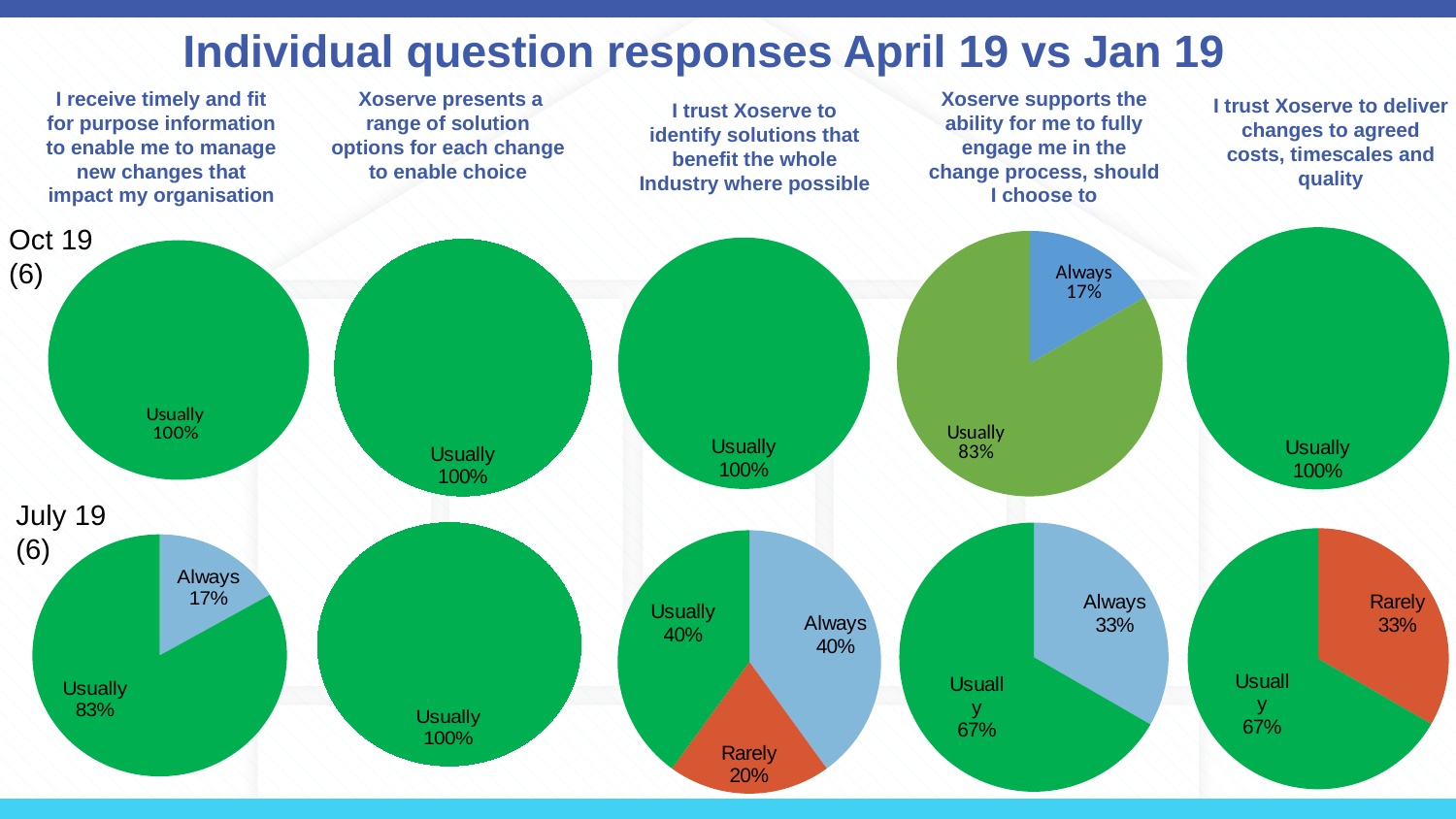
In the July 19 pie chart for "I trust Xoserve to deliver changes to agreed costs, timescales and quality", what percentage of responses is Rarely? 33% In the Oct 19 pie chart for "Xoserve supports the ability for me to fully engage me in the change process, should I choose to", what percentage of responses is Always? 17% In the Oct 19 pie chart for "Xoserve supports the ability for me to fully engage me in the change process, should I choose to", which is larger, Usually or Always? Usually How many slices does the July 19 pie chart for "I trust Xoserve to identify solutions that benefit the whole Industry where possible" have? 3 What is the title of the slide? Individual question responses April 19 vs Jan 19 In the July 19 pie chart for "I trust Xoserve to identify solutions that benefit the whole Industry where possible", which response category is the smallest? Rarely In the July 19 pie chart for "I receive timely and fit for purpose information to enable me to manage new changes that impact my organisation", what percentage of responses is Usually? 83% In the July 19 pie chart for "Xoserve supports the ability for me to fully engage me in the change process, should I choose to", which response category is the largest? Usually In the July 19 pie chart for "Xoserve supports the ability for me to fully engage me in the change process, should I choose to", what is the difference between the Usually and Always percentages? 34% In the Oct 19 pie chart for "Xoserve presents a range of solution options for each change to enable choice", what percentage of responses is Usually? 100% What type of chart is used on this slide to show the question responses? Pie chart In the July 19 pie chart for "I trust Xoserve to identify solutions that benefit the whole Industry where possible", what share of responses is Rarely? 20%